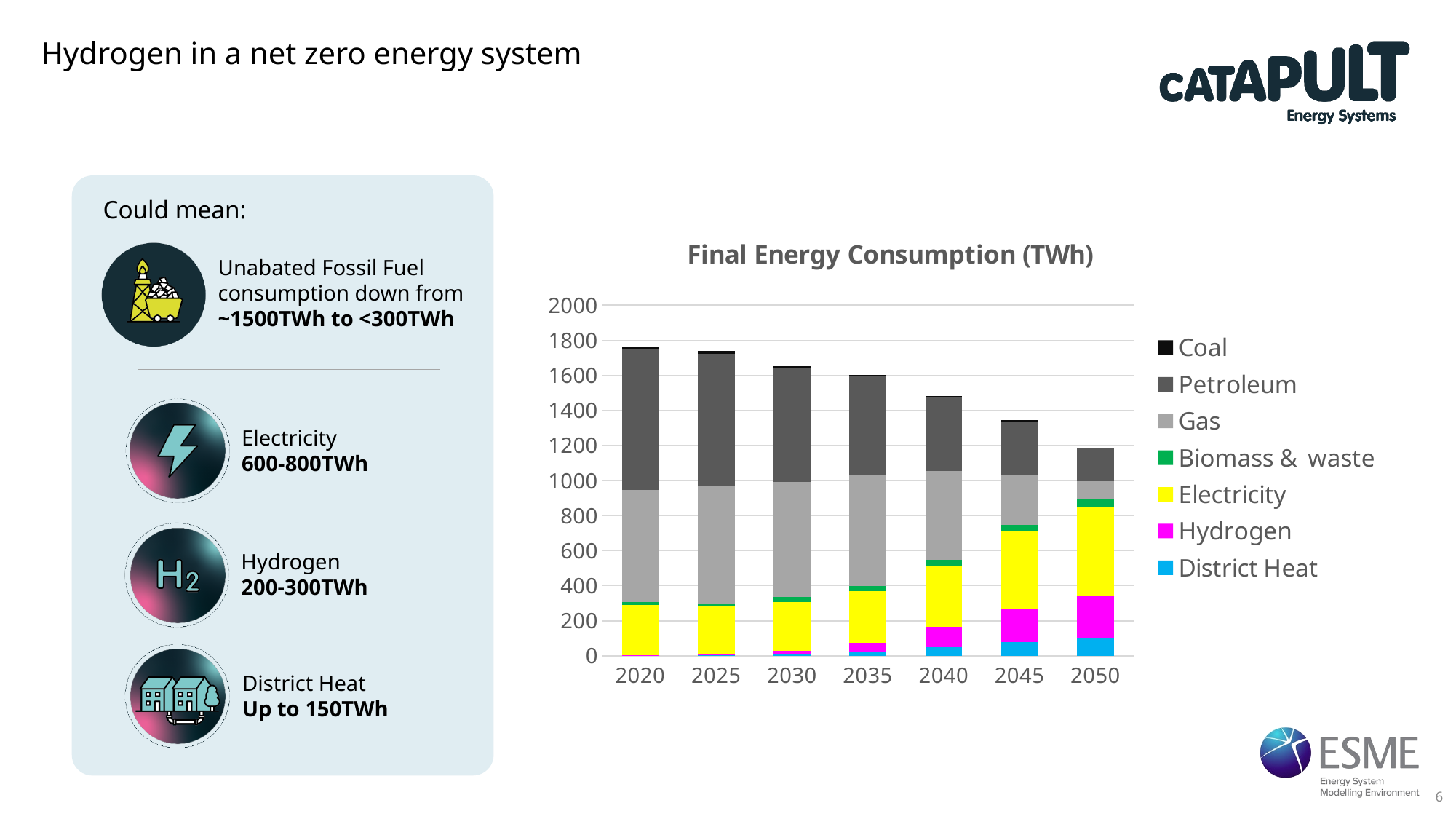
Which year has the lowest total final energy consumption? 2050 Is the total final energy consumption for 2045 greater or less than 1400? less Do the total bar heights rise or fall from 2020 to 2050? Fall How many years are shown along the x axis of the chart? 7 Which colour represents Electricity in the chart? Yellow Is the total final energy consumption for 2050 greater or less than 1000? greater Which year has the larger Hydrogen segment, 2020 or 2050? 2050 What kind of chart is shown on the slide? Stacked bar chart Which year has the larger total final energy consumption, 2020 or 2050? 2020 How many series does the chart legend list? 7 Is the total final energy consumption for 2040 greater or less than 1400? greater What is the title of the chart? Final Energy Consumption (TWh)